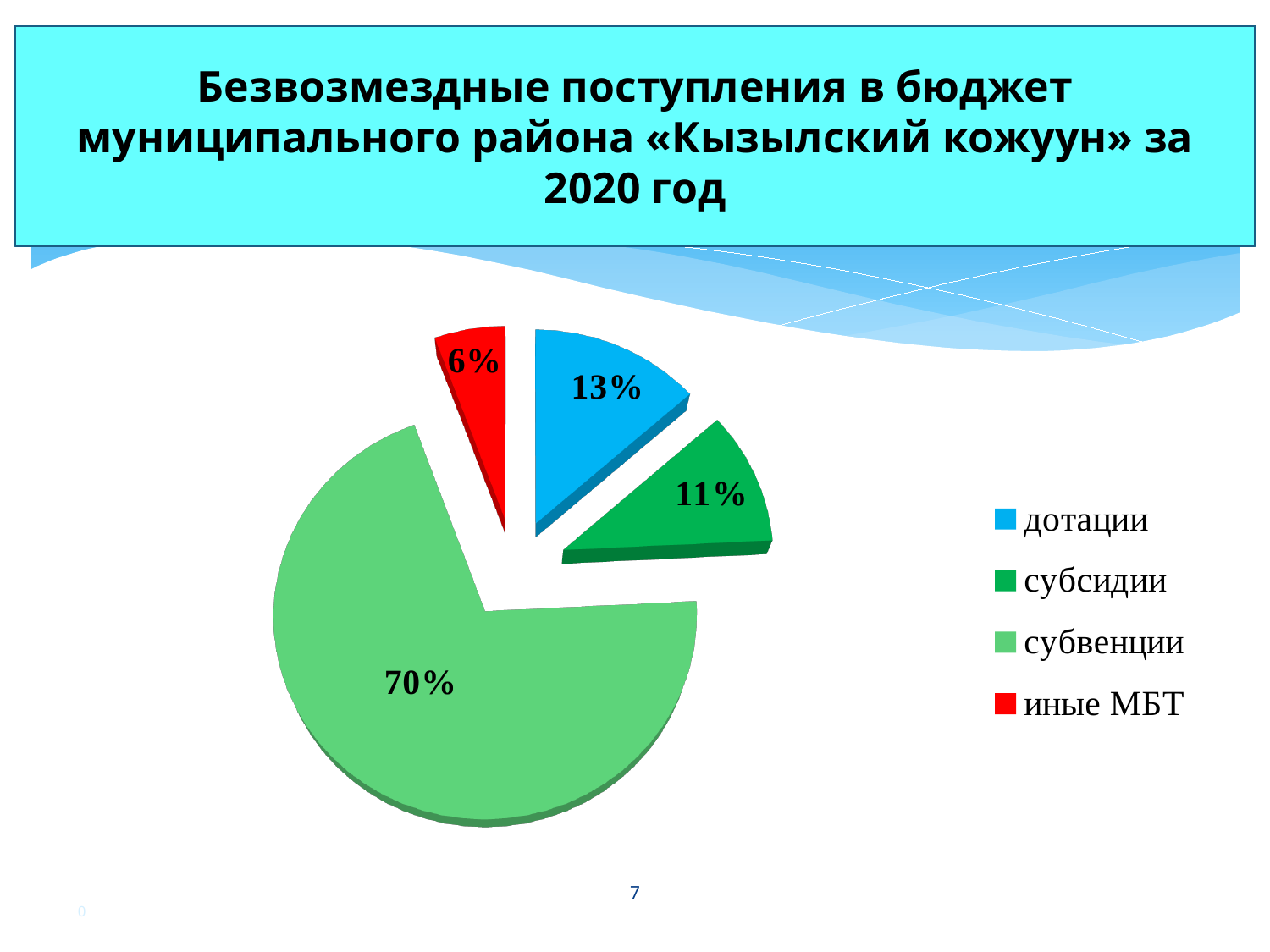
What is the difference between the shares of дотации and иные МБТ? 7% What is the value shown for дотации? 13% Which is larger, the share of дотации or the share of субсидии? дотации What colour is the slice for иные МБТ? red What is the difference between the shares of субвенции and дотации? 57% What is the value shown for субсидии? 11% What is the value shown for иные МБТ? 6% How many categories does the pie chart show? 4 What share of the pie does субвенции account for? 70% What kind of chart is shown on the slide? pie chart Which category has the smallest slice of the pie? иные МБТ Which category has the largest slice of the pie? субвенции